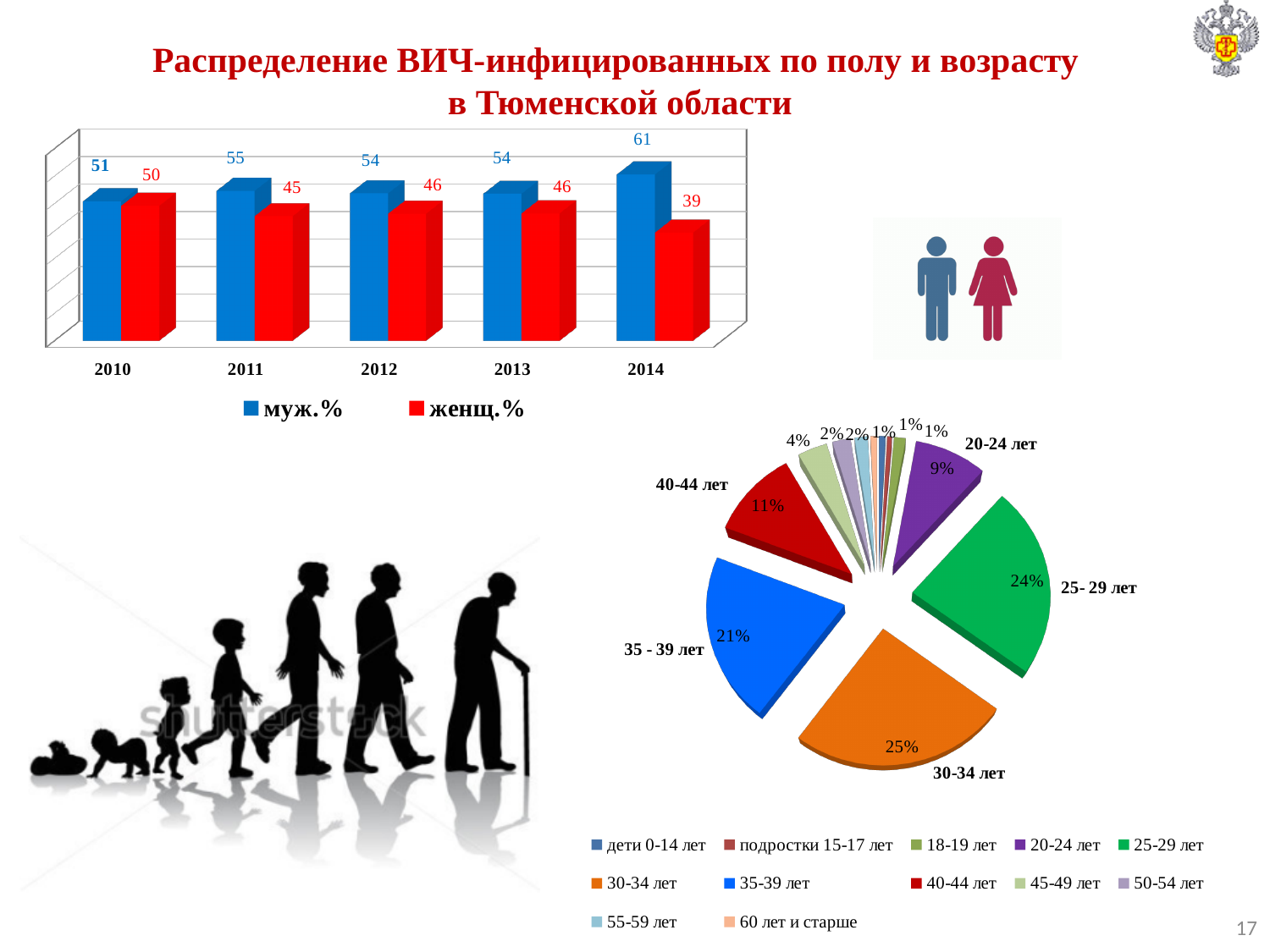
In the pie chart, what share does the 30-34 лет slice have? 25% In the bar chart, how many years are shown on the x axis? 5 In the bar chart, what is the value for муж.% in 2014? 61 In the bar chart, which year has the lowest value for женщ.%? 2014 In the bar chart, which year has the highest value for муж.%? 2014 In the bar chart, how many series does the legend list? 2 In the pie chart, which age group has the largest slice? 30-34 лет What kind of chart is the bottom-right chart? pie chart In the bar chart, which is larger in 2010: муж.% or женщ.%? муж.% In the bar chart, does the value for женщ.% rise or fall from 2013 to 2014? fall In the bar chart, what is the difference between муж.% and женщ.% in 2014? 22 In the bar chart, what is the value for женщ.% in 2011? 45